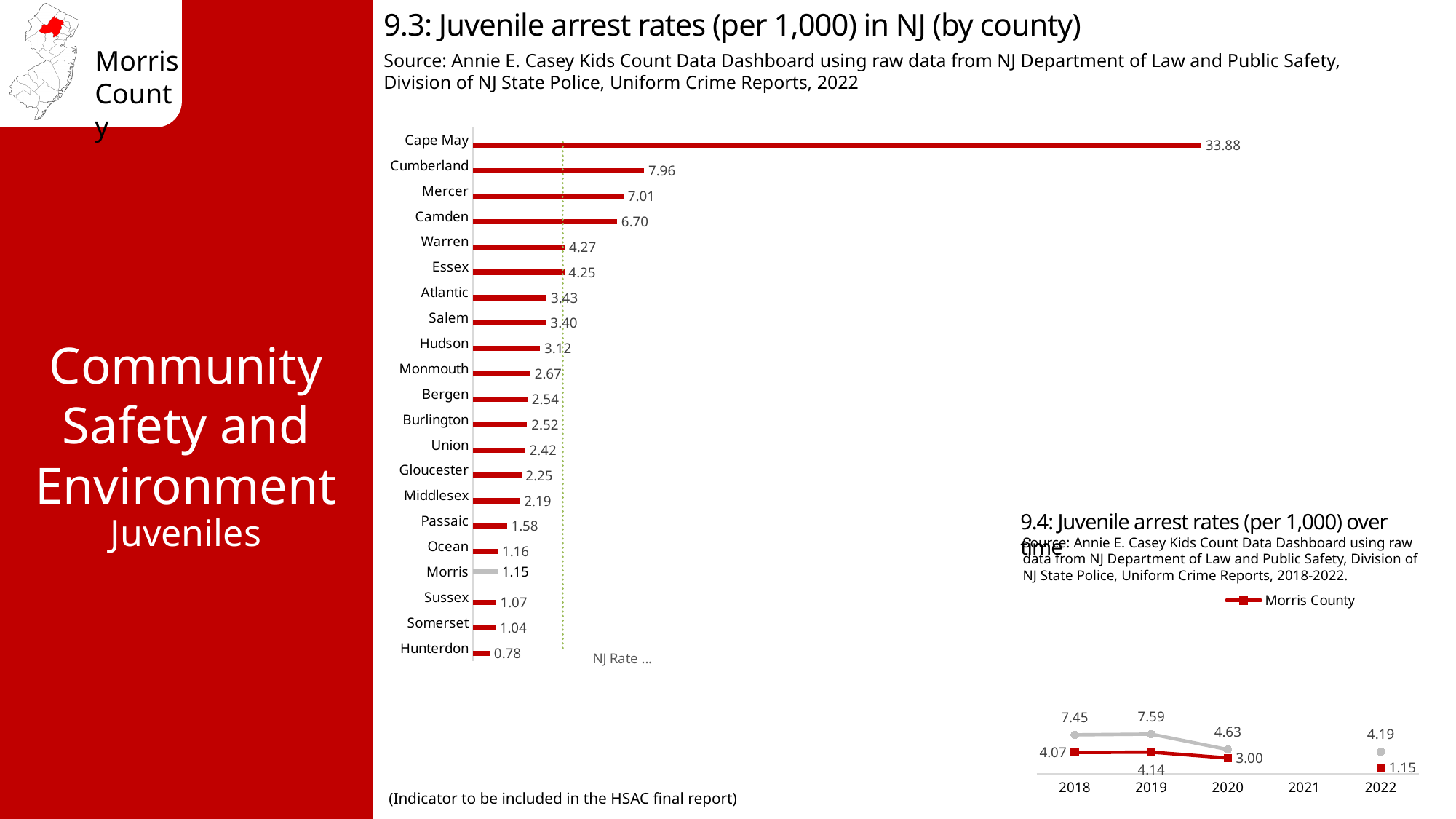
What type of chart is '9.4: Juvenile arrest rates (per 1,000) over time'? Line chart What type of chart is '9.3: Juvenile arrest rates (per 1,000) in NJ (by county)'? Bar chart In the chart '9.3: Juvenile arrest rates (per 1,000) in NJ (by county)', what is the value for Cape May? 33.88 In the chart '9.4: Juvenile arrest rates (per 1,000) over time', what is the Morris County value for 2022? 1.15 In the chart '9.3: Juvenile arrest rates (per 1,000) in NJ (by county)', what is the value for Morris? 1.15 How many counties are shown in the chart '9.3: Juvenile arrest rates (per 1,000) in NJ (by county)'? 21 In the chart '9.3: Juvenile arrest rates (per 1,000) in NJ (by county)', which county has the lowest juvenile arrest rate? Hunterdon In the chart '9.3: Juvenile arrest rates (per 1,000) in NJ (by county)', which county has the highest juvenile arrest rate? Cape May In the chart '9.3: Juvenile arrest rates (per 1,000) in NJ (by county)', which has a higher value, Camden or Warren? Camden In the chart '9.3: Juvenile arrest rates (per 1,000) in NJ (by county)', what is the difference between the values for Cumberland and Mercer? 0.95 In the chart '9.4: Juvenile arrest rates (per 1,000) over time', what is the Morris County value for 2018? 4.07 In the chart '9.4: Juvenile arrest rates (per 1,000) over time', what is the difference between the Morris County values for 2019 and 2020? 1.14